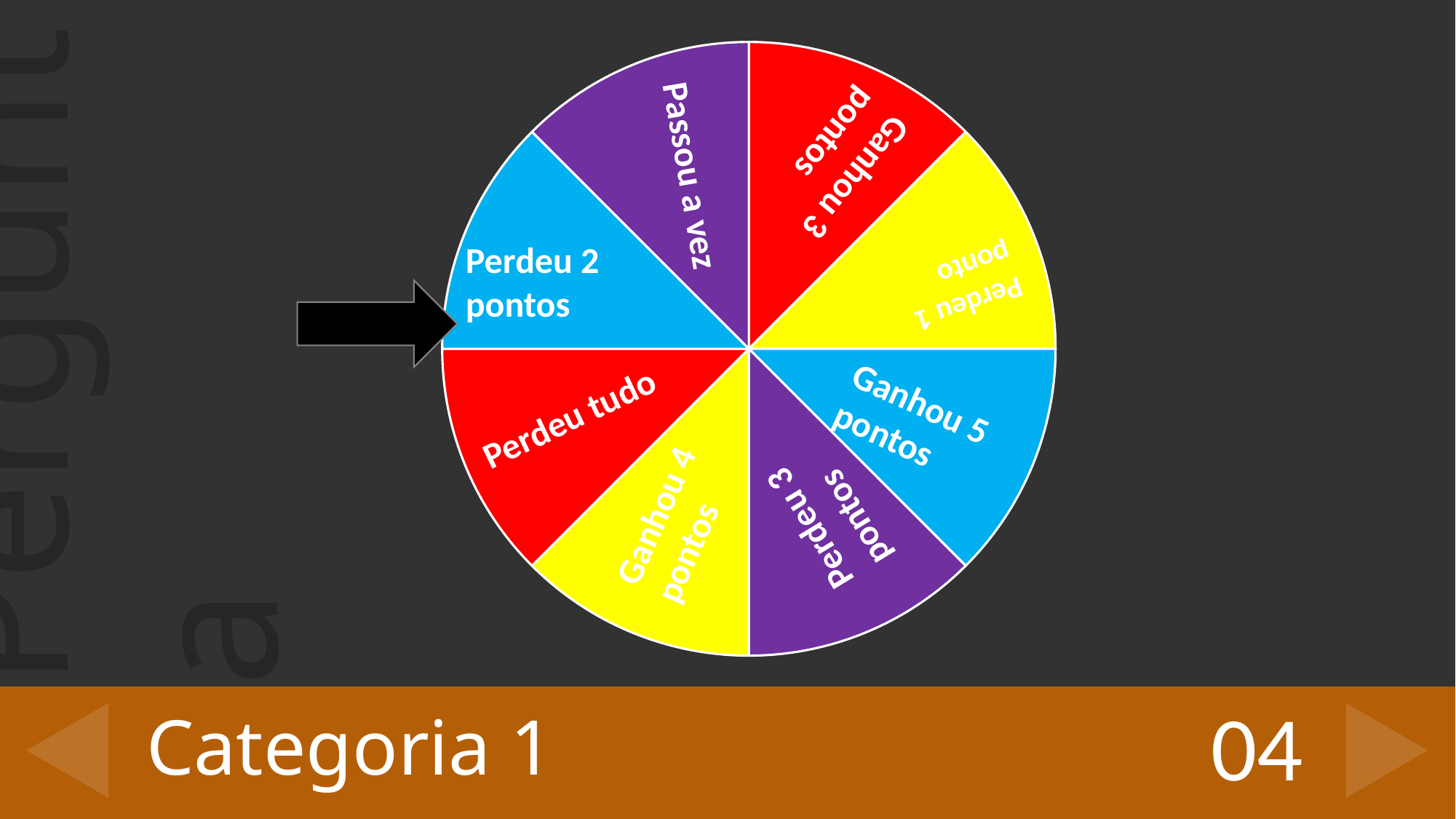
How many slices does the wheel on the slide have? 8 What is the label of the yellow slice on the right side of the wheel? Perdeu 1 ponto What is the label of the red slice at the top right of the wheel? Ganhou 3 pontos What is the label of the blue slice on the right side of the wheel? Ganhou 5 pontos Which slice of the wheel is the black arrow pointing at? Perdeu 2 pontos What is the label of the yellow slice at the bottom left of the wheel? Ganhou 4 pontos What colour is the slice labelled "Perdeu tudo"? red What kind of chart is shown on the slide? pie chart Which slice is labelled "Passou a vez"? the purple slice at the top left What is the label of the purple slice at the bottom right of the wheel? Perdeu 3 pontos